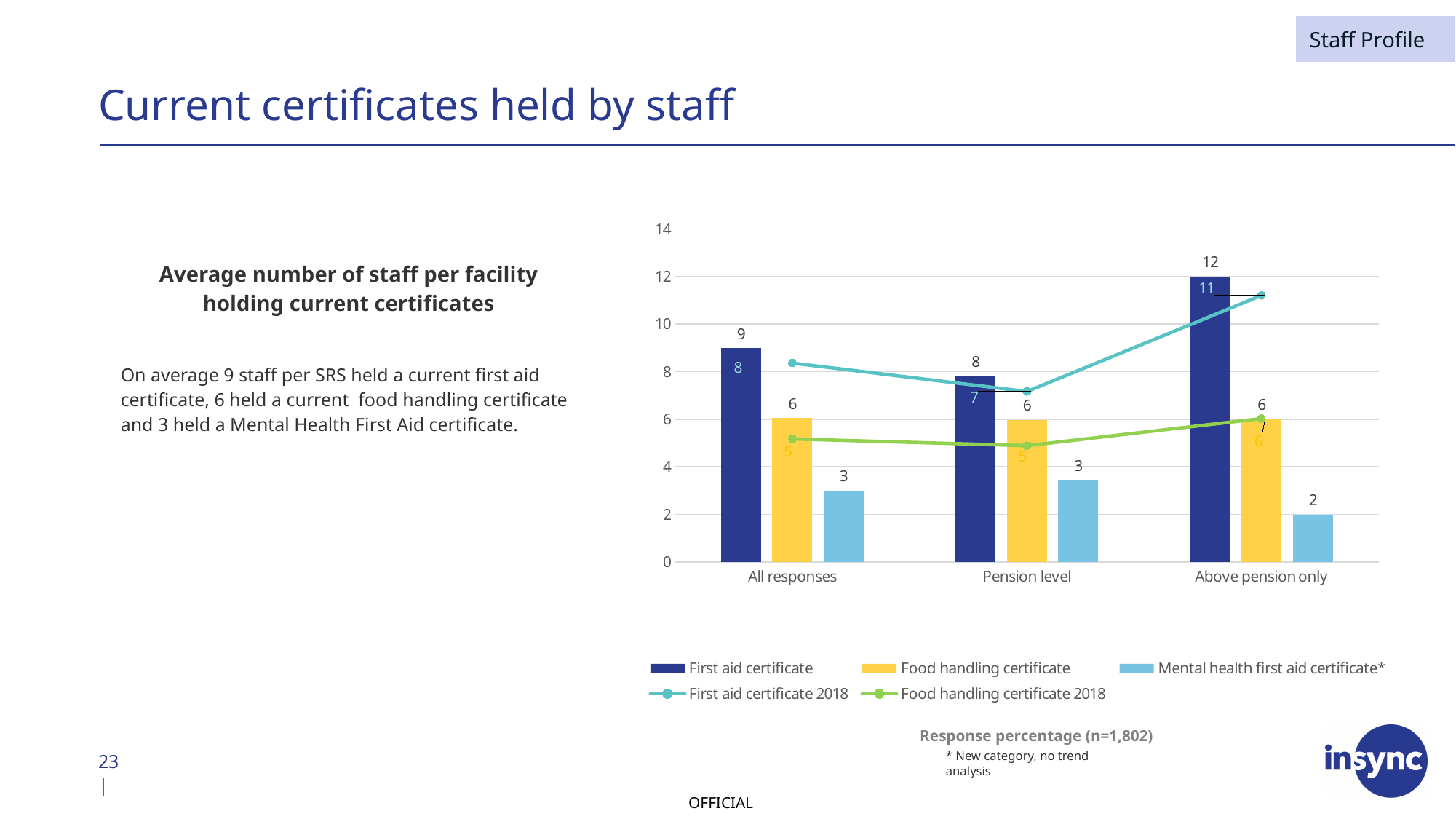
Which is larger for Pension level: the First aid certificate bar or the Food handling certificate bar? First aid certificate Is the First aid certificate bar for Above pension only greater or less than 10? greater What kind of chart is shown on the slide? Combined bar and line chart What is the value of the Mental health first aid certificate bar for Above pension only? 2 What is the value of the Food handling certificate 2018 line at All responses? 5 How many series does the legend list? 5 What is the value of the First aid certificate 2018 line at Pension level? 7 Which category has the highest First aid certificate bar? Above pension only How many categories are shown on the x axis? 3 Which category has the lowest Mental health first aid certificate bar? Above pension only What is the value of the First aid certificate bar for All responses? 9 What is the difference between the First aid certificate bar for Above pension only and for Pension level? 4